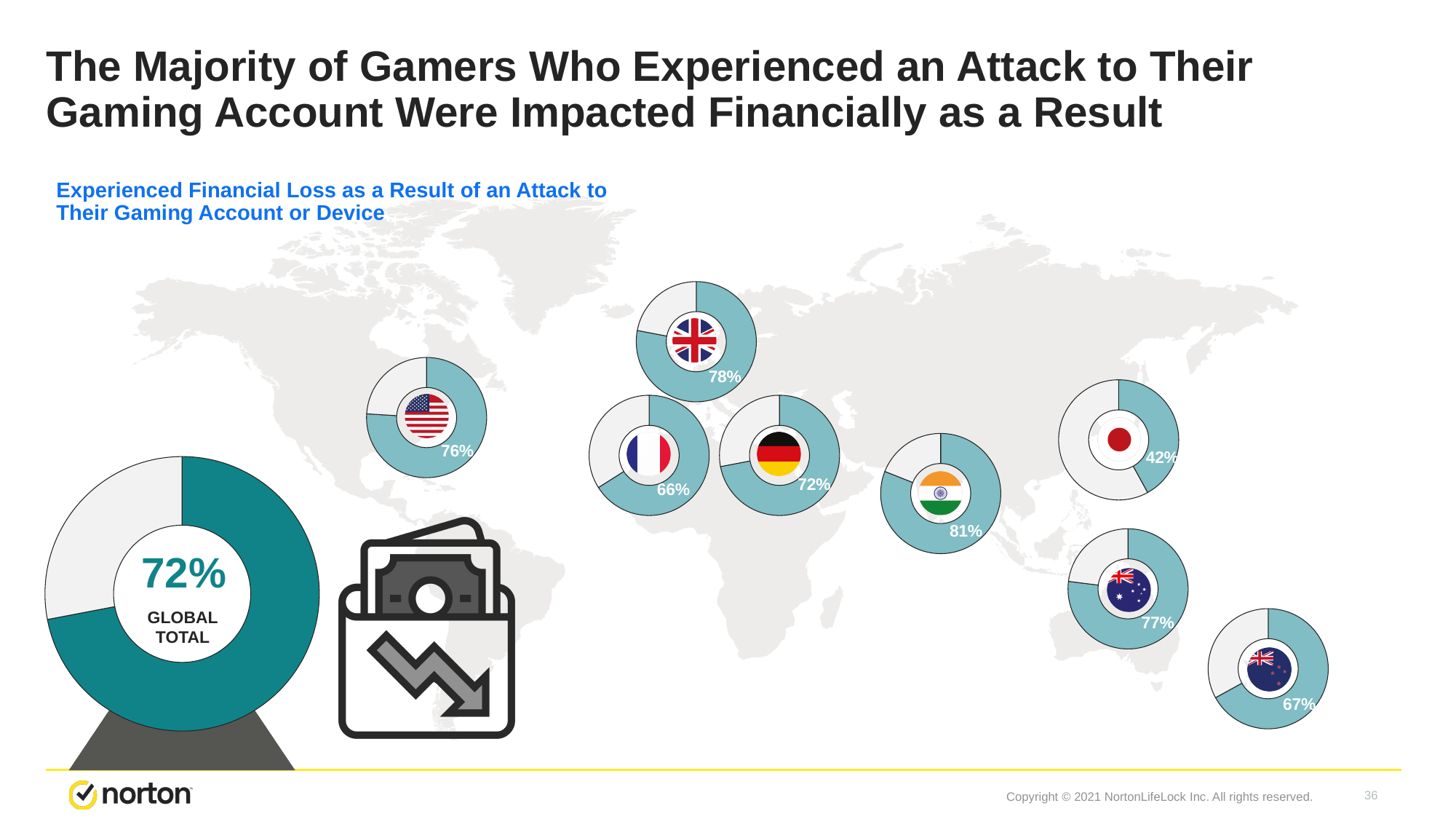
What percentage is shown in the donut chart with the Japan flag? 42% What percentage is shown in the donut chart with the United Kingdom flag? 78% What is the difference between the percentage shown for India and the percentage shown for Japan? 39% What percentage is shown in the donut chart with the France flag? 66% Which is larger, the percentage shown for the United States or the percentage shown for Australia? Australia What is the global total percentage of gamers who experienced financial loss as a result of an attack to their gaming account or device? 72% Which country's donut chart shows the same percentage as the global total? Germany Which country's donut chart shows the lowest percentage of gamers who experienced financial loss? Japan How many country donut charts are shown on the world map? 8 What kind of chart is used to show the global total of 72%? Donut chart What percentage is shown in the donut chart with the India flag? 81% Which country's donut chart shows the highest percentage of gamers who experienced financial loss? India